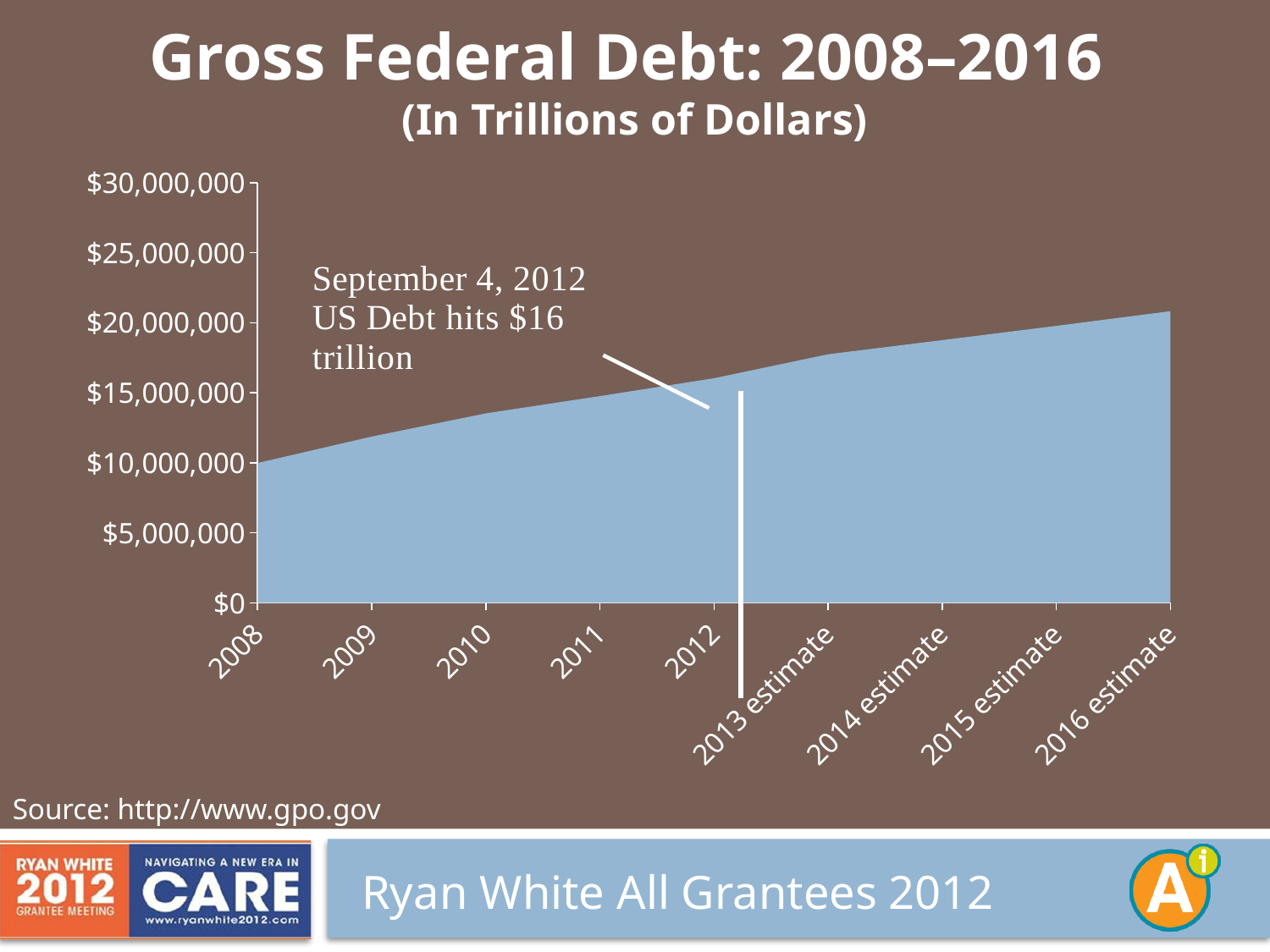
Is the value for 2010 greater or less than $15,000,000? less Is the value for the 2016 estimate greater or less than $25,000,000? less What kind of chart is shown on the slide? area chart Is the value for the 2014 estimate greater or less than $15,000,000? greater Which is larger, the value for 2009 or the value for the 2015 estimate? 2015 estimate Which year has the highest gross federal debt on the chart? 2016 estimate Do the values rise or fall from 2008 to the 2016 estimate? rise What is the title of the chart? Gross Federal Debt: 2008–2016 (In Trillions of Dollars) Which year has the lowest gross federal debt on the chart? 2008 How many years (data points) are plotted along the x axis? 9